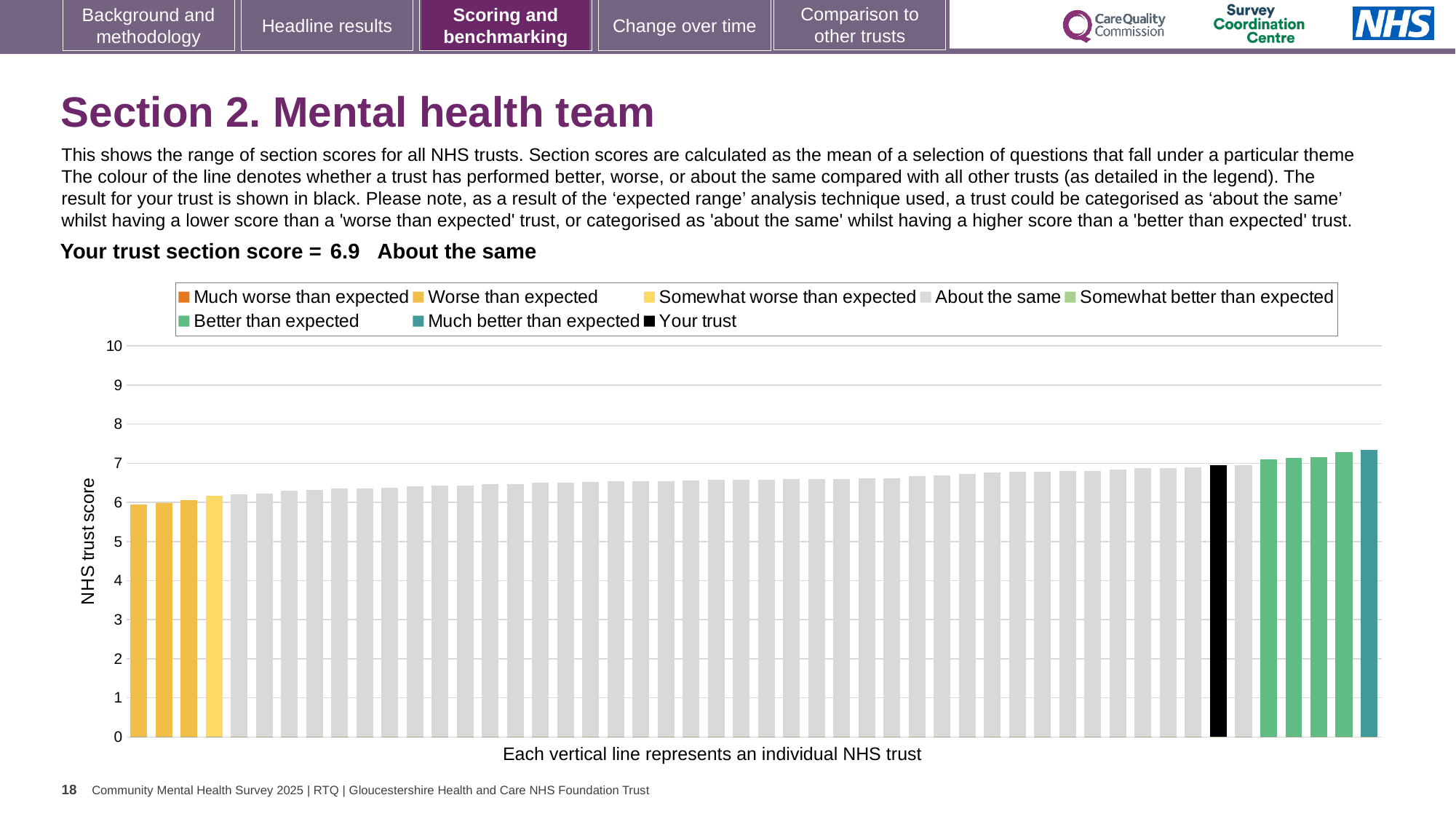
How many entries does the chart legend list? 8 Is the value of the tallest bar greater or less than 7? greater Do the bar heights rise or fall from left to right across the chart? rise What kind of chart is used to show the NHS trust scores? bar chart Is the value of the lowest bar greater or less than 5? greater Which category is the trust's own score placed in? About the same How many bars are coloured as 'Much worse than expected'? 0 How many bars are coloured as 'Worse than expected'? 3 What is the label on the vertical axis of the chart? NHS trust score Which legend category does the tallest bar belong to? Much better than expected Which legend category does the shortest bar belong to? Worse than expected What is the trust's section score shown on the slide? 6.9